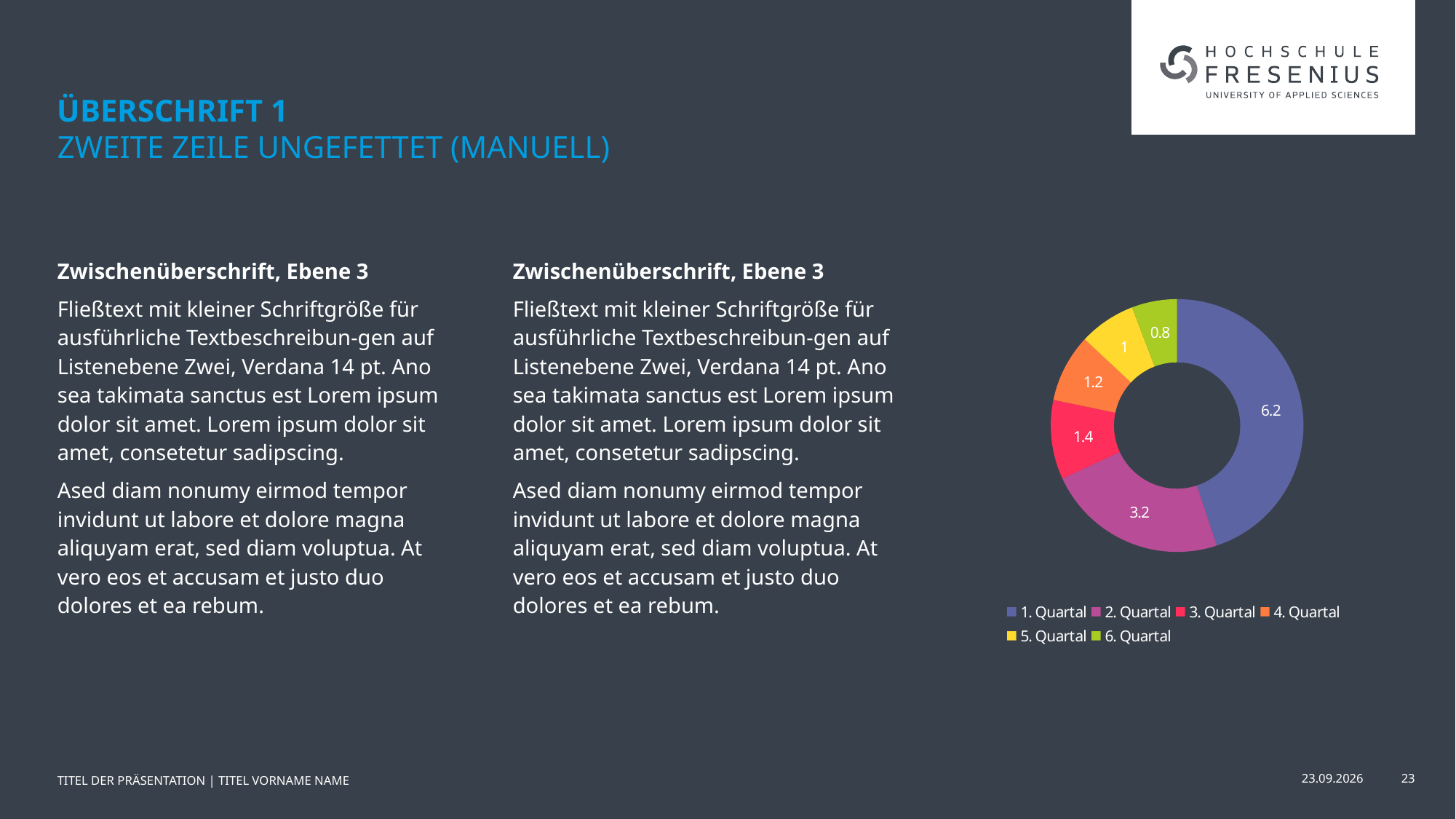
How many categories does the doughnut chart show? 6 What kind of chart is shown on the slide? doughnut chart Which colour represents 5. Quartal in the legend? yellow What is the difference between the values for 3. Quartal and 4. Quartal? 0.2 What is the value for 3. Quartal in the doughnut chart? 1.4 Which category has the smallest value in the doughnut chart? 6. Quartal What is the difference between the values for 1. Quartal and 2. Quartal? 3 Which is larger, the value for 2. Quartal or the value for 3. Quartal? 2. Quartal What is the total of all values in the doughnut chart? 13.8 What is the value for 6. Quartal in the doughnut chart? 0.8 Which category has the largest value in the doughnut chart? 1. Quartal What is the value for 1. Quartal in the doughnut chart? 6.2